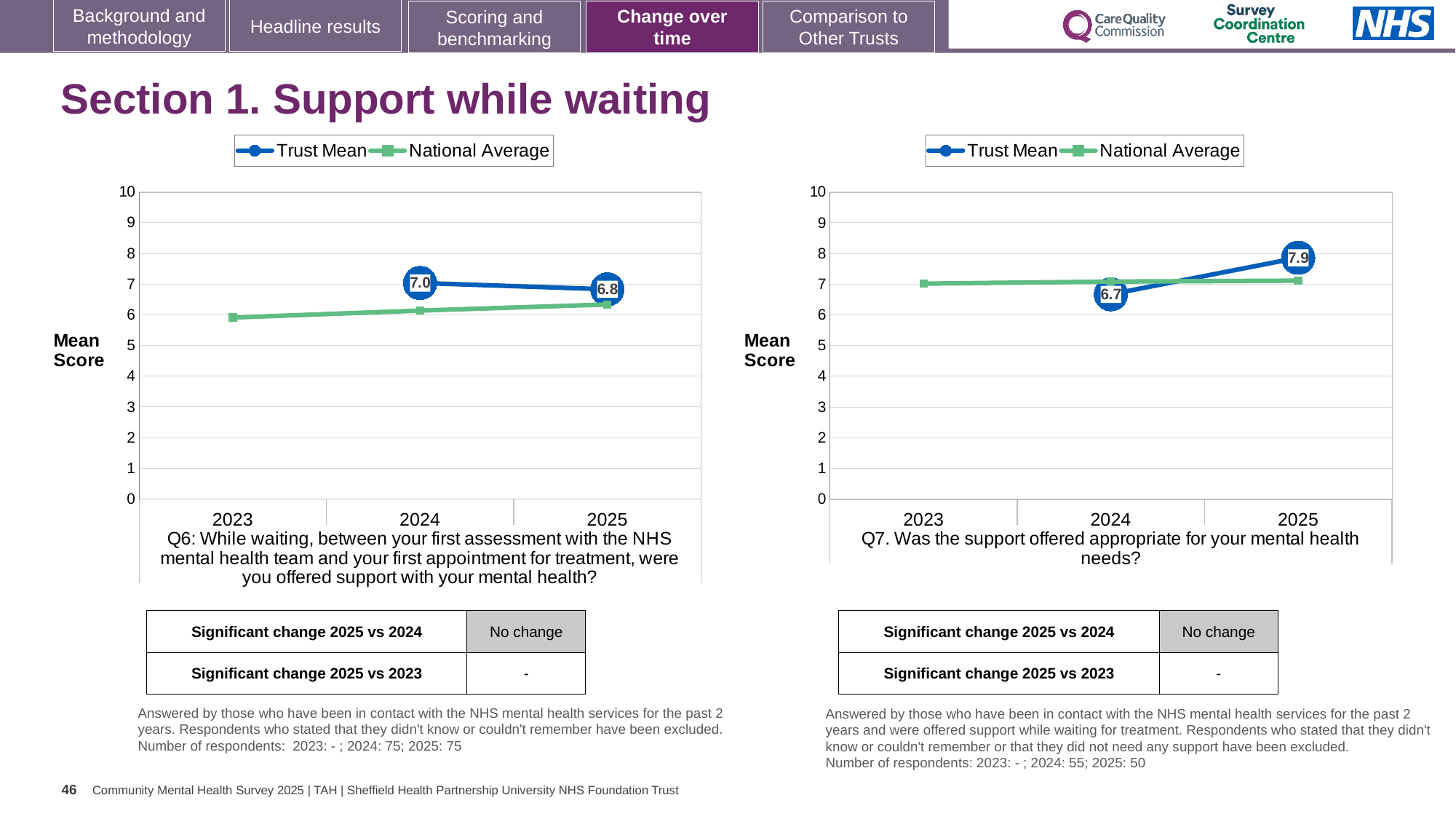
What kind of chart is the Q6 chart on the left? line chart In the Q7 chart on the right, did the Trust Mean rise or fall from 2024 to 2025? rise In the Q7 chart on the right, by how much did the Trust Mean change from 2024 to 2025? 1.2 In the Q7 chart on the right, which is larger in 2025, the Trust Mean or the National Average? Trust Mean In the Q6 chart on the left, did the Trust Mean rise or fall from 2024 to 2025? fall In the Q7 chart on the right, what is the Trust Mean score for 2024? 6.7 In the Q6 chart on the left, what is the difference between the Trust Mean for 2024 and 2025? 0.2 In the Q6 chart on the left, is the National Average for 2025 greater or less than 6? greater In the Q7 chart on the right, what is the Trust Mean score for 2025? 7.9 How many series does the legend of the Q7 chart on the right list? 2 In the Q6 chart on the left, what is the Trust Mean score for 2025? 6.8 In the Q6 chart on the left, what is the Trust Mean score for 2024? 7.0